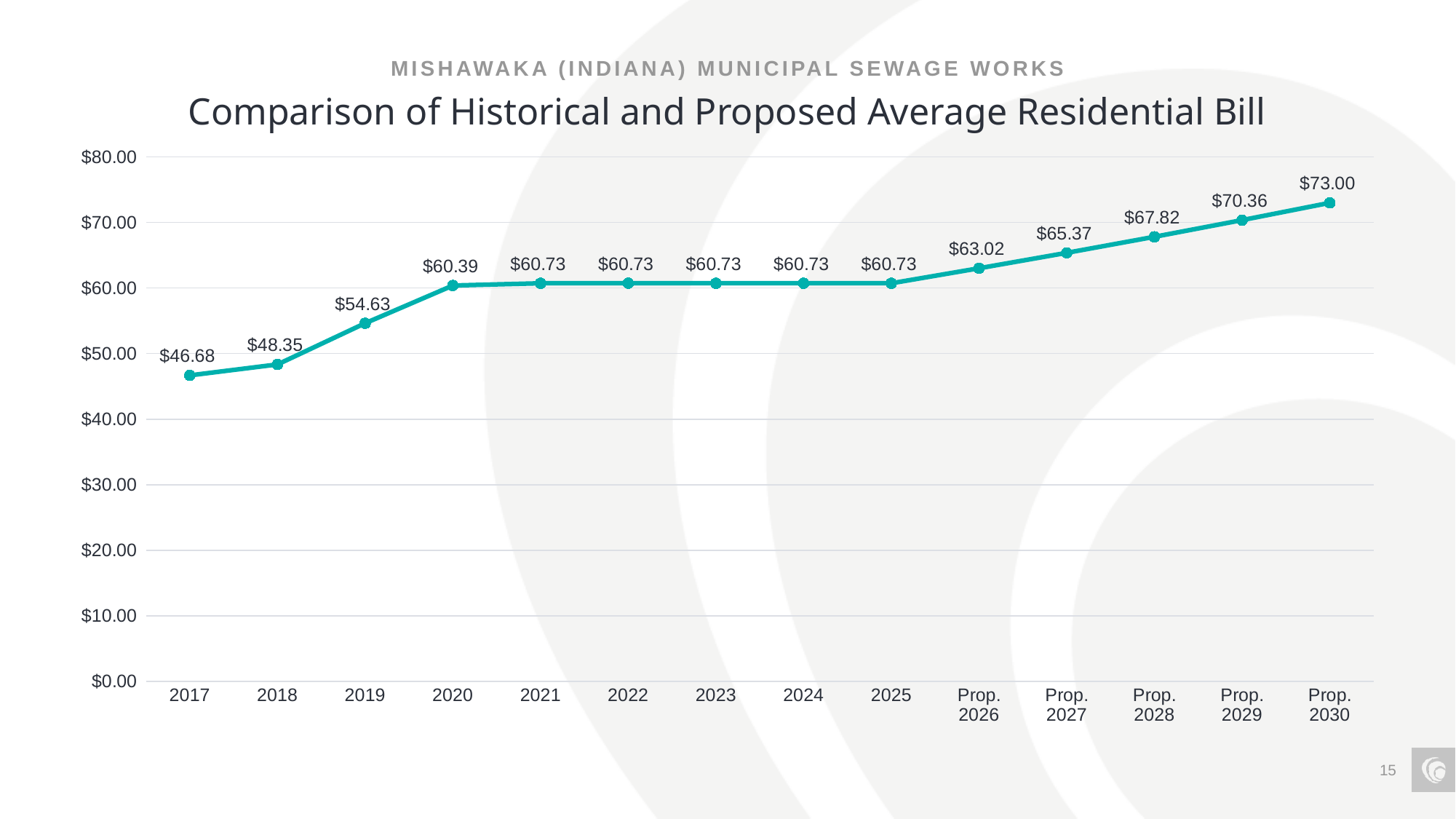
What is the value shown for 2020? $60.39 Do the values generally rise or fall from 2017 to Prop. 2030? Rise What is the difference between the values for Prop. 2030 and 2017? $26.32 What is the value plotted for Prop. 2030? $73.00 What is the difference between the values for 2019 and 2018? $6.28 What kind of chart is shown on the slide? Line chart Which is larger, the value for Prop. 2028 or the value for 2025? Prop. 2028 Which year has the lowest average residential bill on the chart? 2017 What is the value shown for Prop. 2027? $65.37 How many data points are plotted on the chart? 14 Which year has the highest average residential bill on the chart? Prop. 2030 What is the average residential bill shown for 2017? $46.68